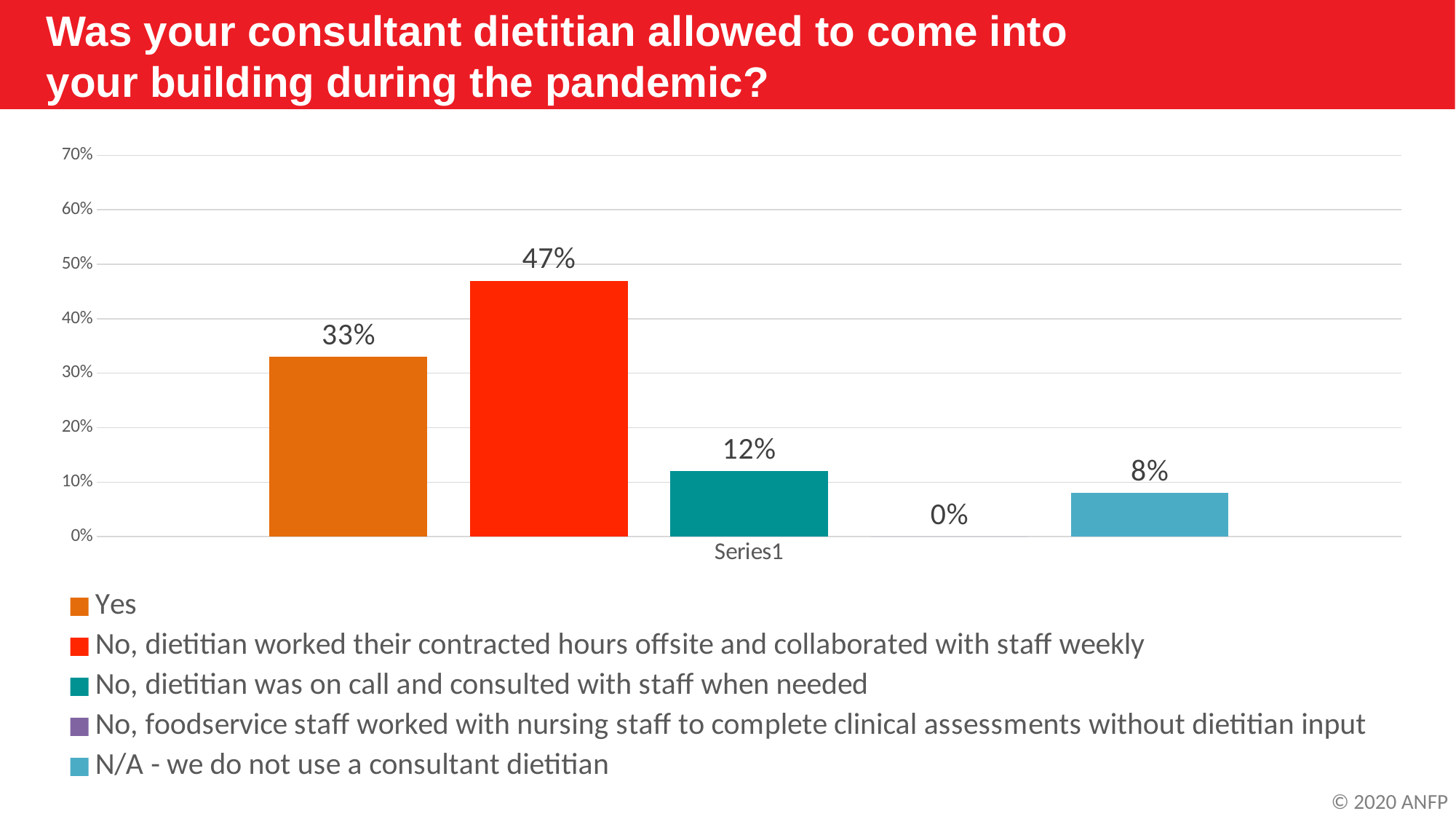
What is the difference in percentage points between "No, dietitian worked their contracted hours offsite and collaborated with staff weekly" and "Yes"? 14% What type of chart is shown on the slide? Bar chart Which is larger: the percentage for "Yes" or for "No, dietitian was on call and consulted with staff when needed"? Yes What percentage answered "N/A - we do not use a consultant dietitian"? 8% What colour is the bar for "Yes"? Orange What percentage answered "No, dietitian was on call and consulted with staff when needed"? 12% How many response options are listed in the legend? 5 Which response option has the highest percentage? No, dietitian worked their contracted hours offsite and collaborated with staff weekly Which response option has the lowest percentage? No, foodservice staff worked with nursing staff to complete clinical assessments without dietitian input What is the highest value shown on the vertical axis? 70% What percentage answered "No, dietitian worked their contracted hours offsite and collaborated with staff weekly"? 47% What percentage of respondents answered "Yes"? 33%